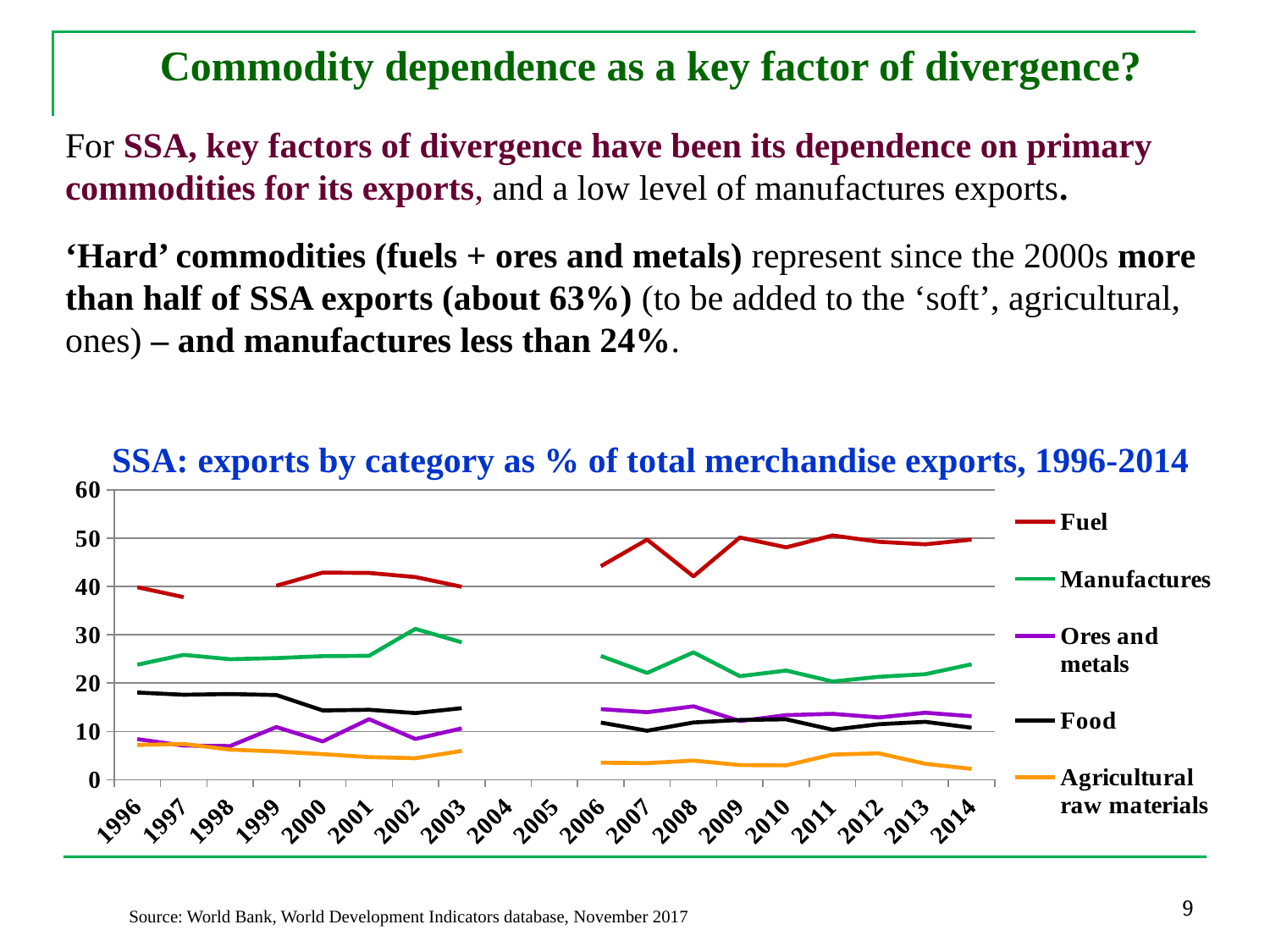
How many series does the chart legend list? 5 Is the value for Fuel in 2008 greater or less than 50? less In 2010, which is larger: Fuel or Manufactures? Fuel Does the Agricultural raw materials series rise or fall from 1996 to 2014? Fall What kind of chart is shown on the slide? Line chart Which series has the lowest value in 2014? Agricultural raw materials What is the title of the chart? SSA: exports by category as % of total merchandise exports, 1996-2014 How many years are labelled on the x axis of the chart? 19 Is the value for Fuel in 2014 greater or less than 40? greater Is the value for Food in 1996 greater or less than 20? less Which series has the highest value in 2014? Fuel